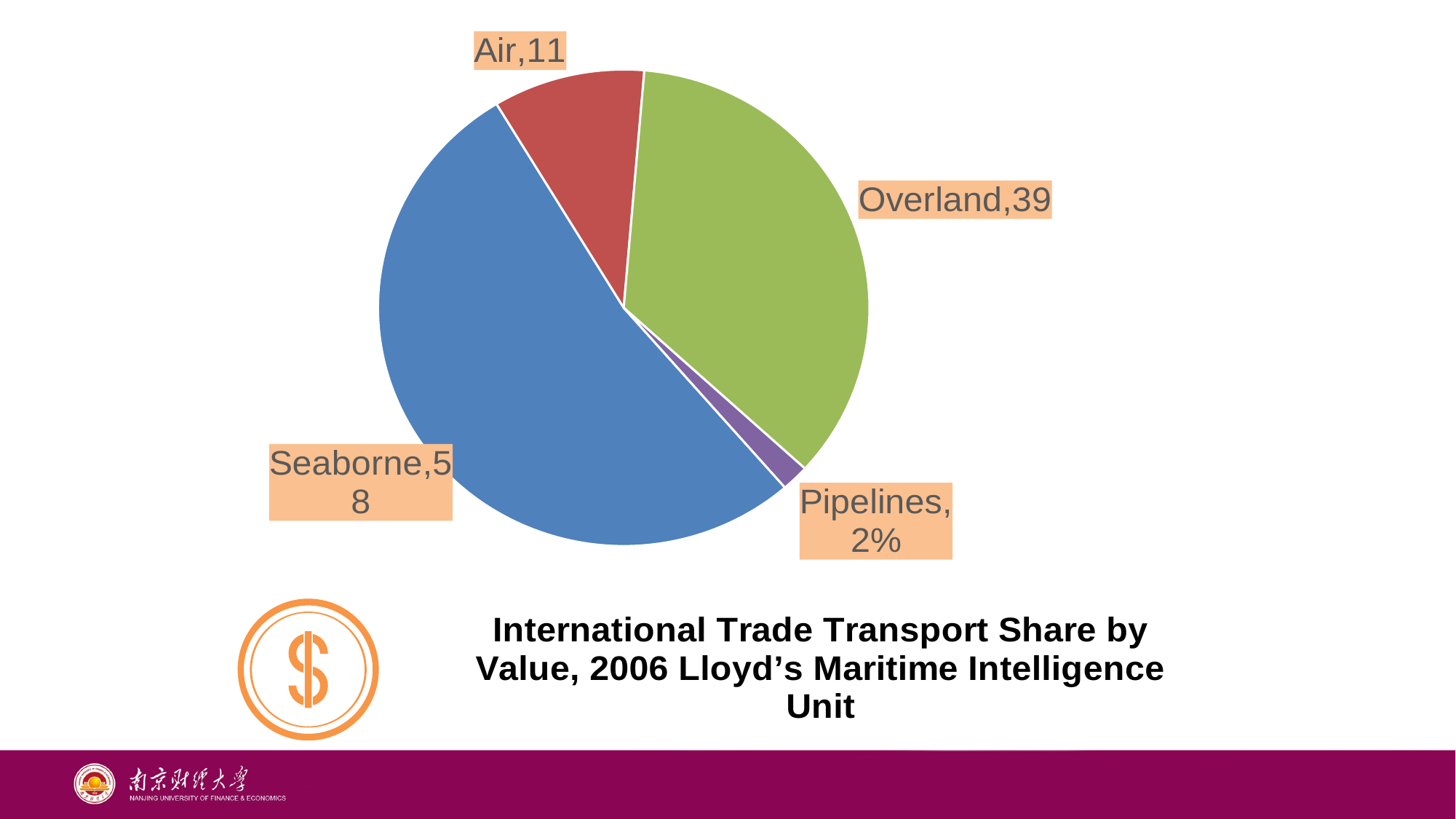
How many slices does the pie chart have? 4 Which transport mode has the largest slice of the pie chart? Seaborne What colour is the Seaborne slice of the pie chart? Blue Which is larger, the Overland slice or the Air slice? Overland What value is shown for the Overland slice of the pie chart? 39 Which transport mode has the smallest slice of the pie chart? Pipelines What value is shown for the Air slice of the pie chart? 11 What kind of chart is shown on the slide? Pie chart What is the difference between the Seaborne value and the Overland value? 19 What value is shown for the Seaborne slice of the pie chart? 58 What is the difference between the Overland value and the Air value? 28 What value is shown for the Pipelines slice of the pie chart? 2%